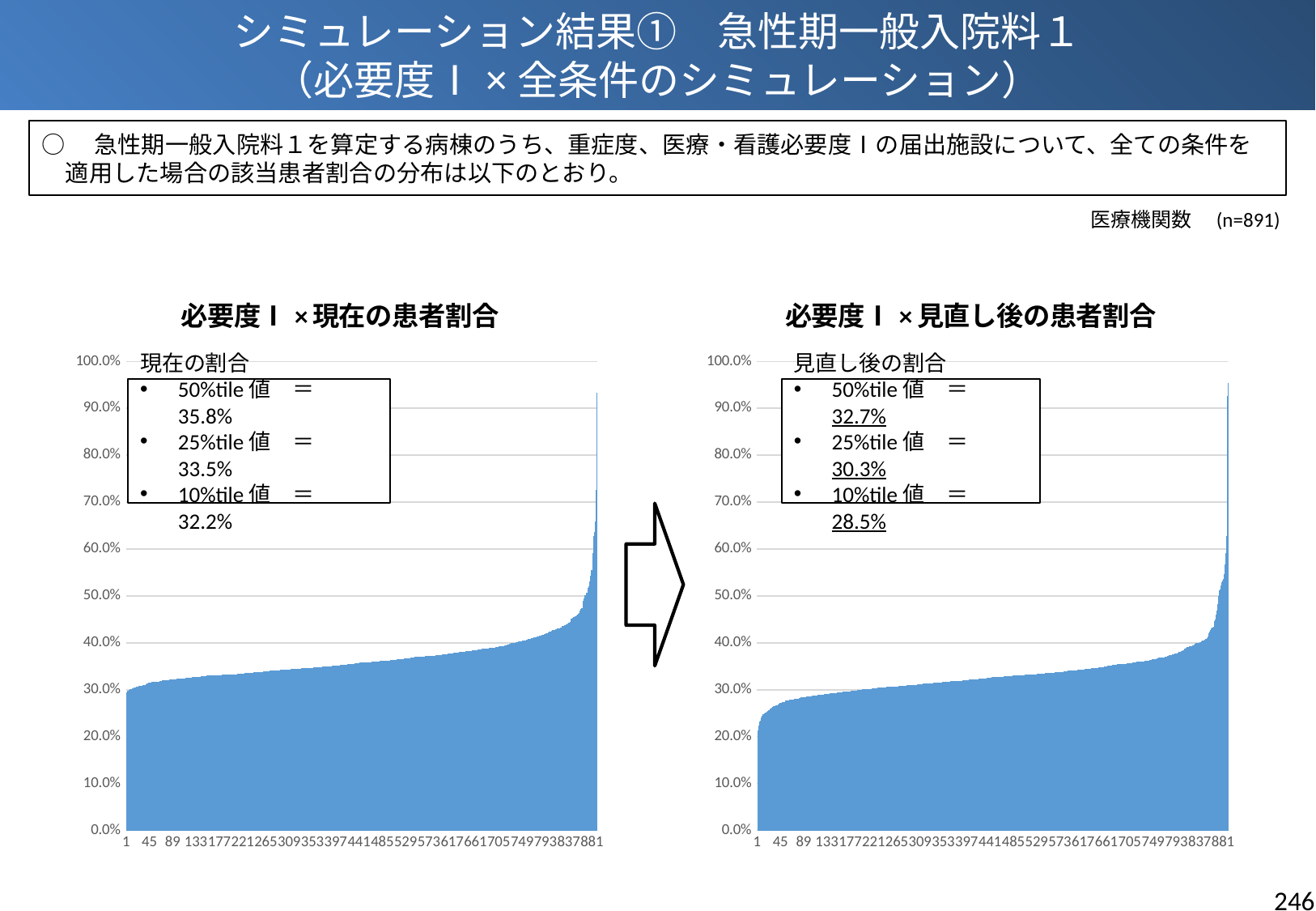
What kind of chart is used on the left (必要度Ⅰ×現在の患者割合)? Area chart In the right chart (必要度Ⅰ×見直し後の患者割合), is the value for the first institution (x = 1) greater or less than 30.0%? less In the left chart (必要度Ⅰ×現在の患者割合), what is the 25%tile value shown? 33.5% Which chart shows the higher 10%tile value, the left chart (現在の患者割合) or the right chart (見直し後の患者割合)? The left chart (現在の患者割合) In the left chart (必要度Ⅰ×現在の患者割合), what is the 10%tile value shown? 32.2% In the right chart (必要度Ⅰ×見直し後の患者割合), do the values rise or fall as you move along the x axis from 1 to 881? Rise In the left chart (必要度Ⅰ×現在の患者割合), what is the 50%tile value shown in the text box? 35.8% How many medical institutions (医療機関数) does the slide state the data covers? n=891 In the right chart (必要度Ⅰ×見直し後の患者割合), what is the 25%tile value shown? 30.3% By how many percentage points does the 50%tile value in the left chart (現在の割合) exceed the 50%tile value in the right chart (見直し後の割合)? 3.1 percentage points In the right chart (必要度Ⅰ×見直し後の患者割合), what is the 50%tile value shown? 32.7% In the right chart (必要度Ⅰ×見直し後の患者割合), what is the 10%tile value shown? 28.5%